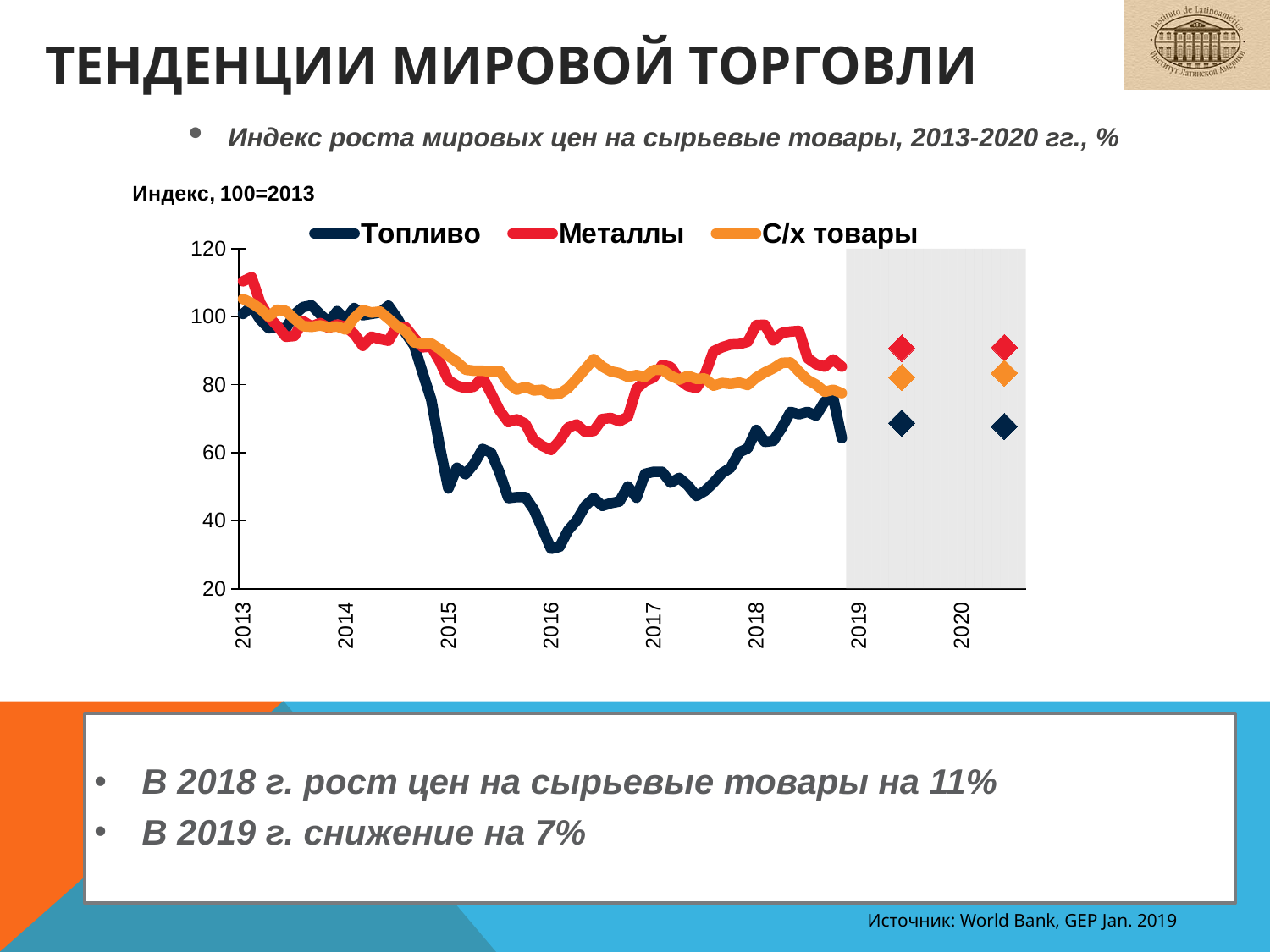
In 2016, which is larger: the value for Топливо or the value for Металлы? Металлы Which series are listed in the chart legend? Топливо, Металлы, С/х товары Does the Топливо line rise or fall between 2014 and 2016? Fall What colour is the Топливо line? Dark blue How many series does the legend list? 3 Is the lowest value of the Топливо line in 2016 greater or less than 40? less Is the value of the Металлы line at the start of 2013 greater or less than 100? greater What kind of chart is shown on the slide? Line chart Which series has the highest value at the start of 2013? Металлы Is the value of the Металлы line in 2018 greater or less than 80? greater How many year labels are shown on the x axis? 8 Which series has the lowest value in 2016? Топливо